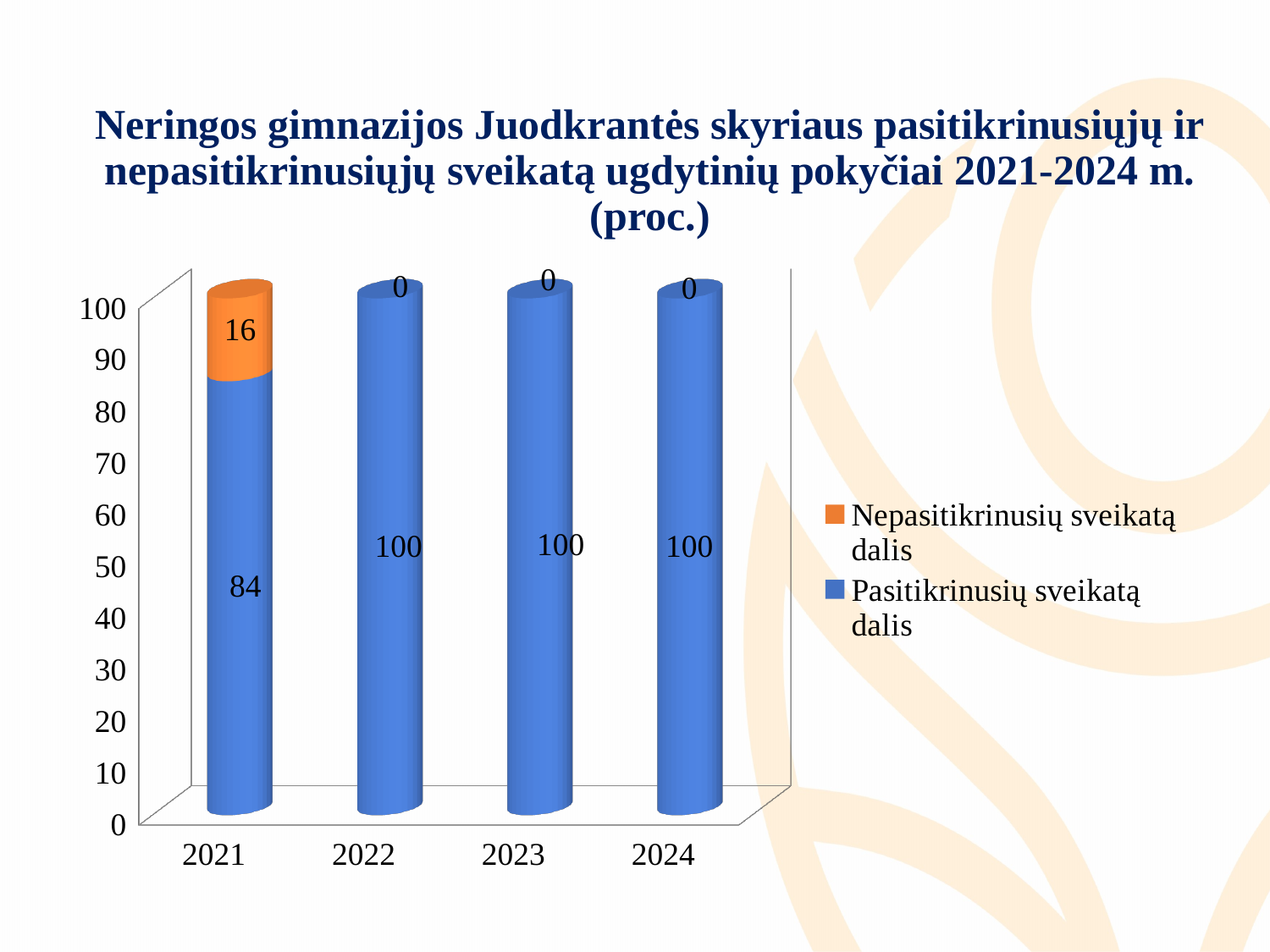
Which year has the highest value for 'Nepasitikrinusių sveikatą dalis'? 2021 What kind of chart is shown on the slide? Stacked bar chart What is the value of 'Nepasitikrinusių sveikatą dalis' for 2024? 0 What is the difference between the 'Pasitikrinusių sveikatą dalis' values for 2022 and 2021? 16 What is the value of 'Pasitikrinusių sveikatą dalis' for 2021? 84 How many years are shown on the x axis? 4 What is the total of the stacked bar for 2021? 100 What is the value of 'Pasitikrinusių sveikatą dalis' for 2023? 100 Which year has the lowest value for 'Pasitikrinusių sveikatą dalis'? 2021 Is the 'Pasitikrinusių sveikatą dalis' value for 2021 larger or smaller than the value for 2024? smaller What is the value of 'Nepasitikrinusių sveikatą dalis' for 2021? 16 How many series does the legend list? 2